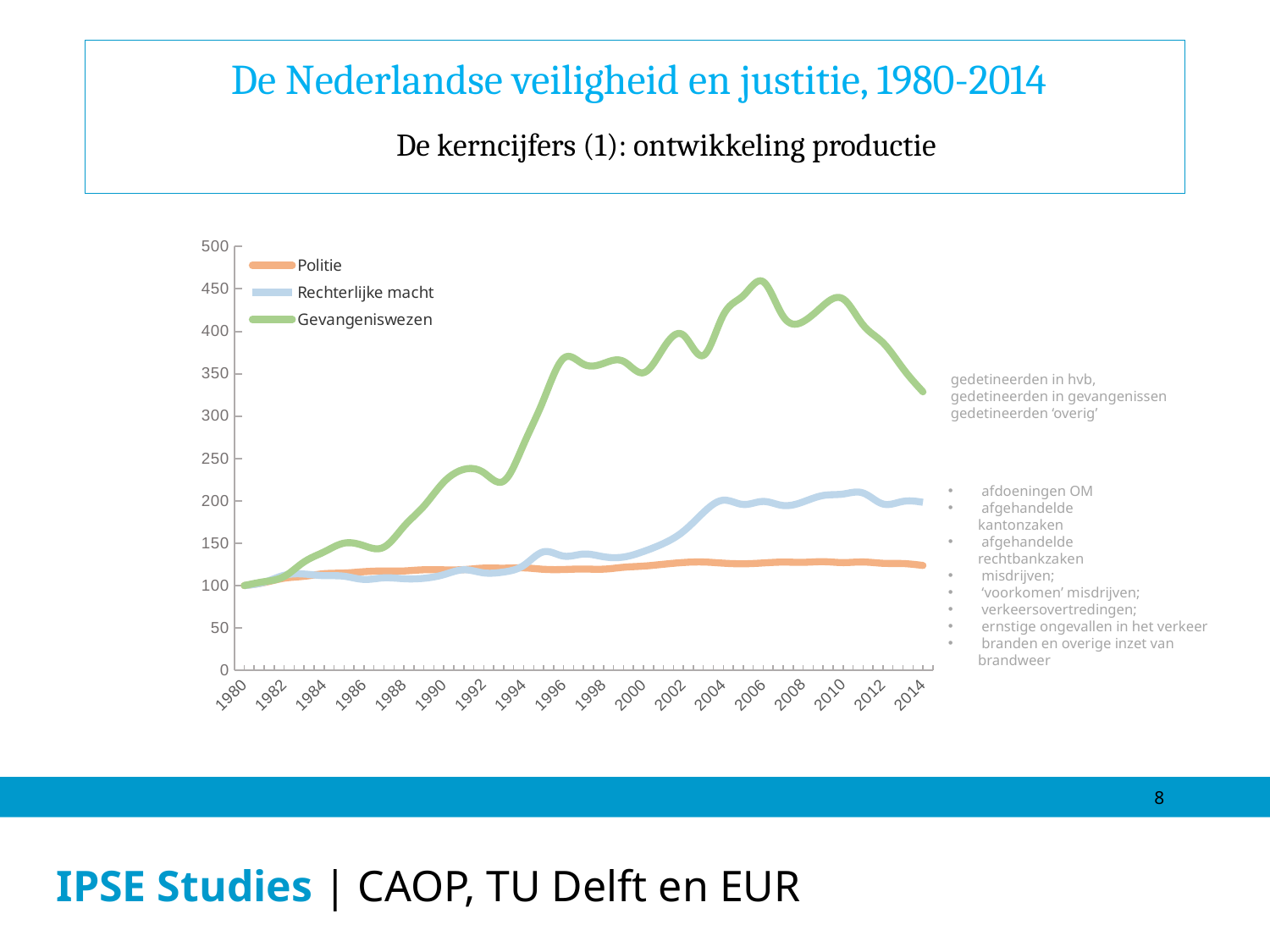
Which is larger in 2014, the value for Rechterlijke macht or the value for Politie? Rechterlijke macht What value do all three series start at in 1980? 100 How many series does the chart's legend list? 3 Which series are listed in the chart's legend? Politie, Rechterlijke macht, Gevangeniswezen Which series has the lowest value in 2014? Politie Which series has the highest value in 2014? Gevangeniswezen Is the value for Gevangeniswezen in 2006 greater or less than 400? greater Is the value for Rechterlijke macht in 2014 greater or less than 150? greater Which colour is used for the Gevangeniswezen line? green What kind of chart is shown on the slide? line chart Is the value for Politie in 2014 greater or less than 150? less Does the Gevangeniswezen line rise or fall between 2006 and 2014? fall